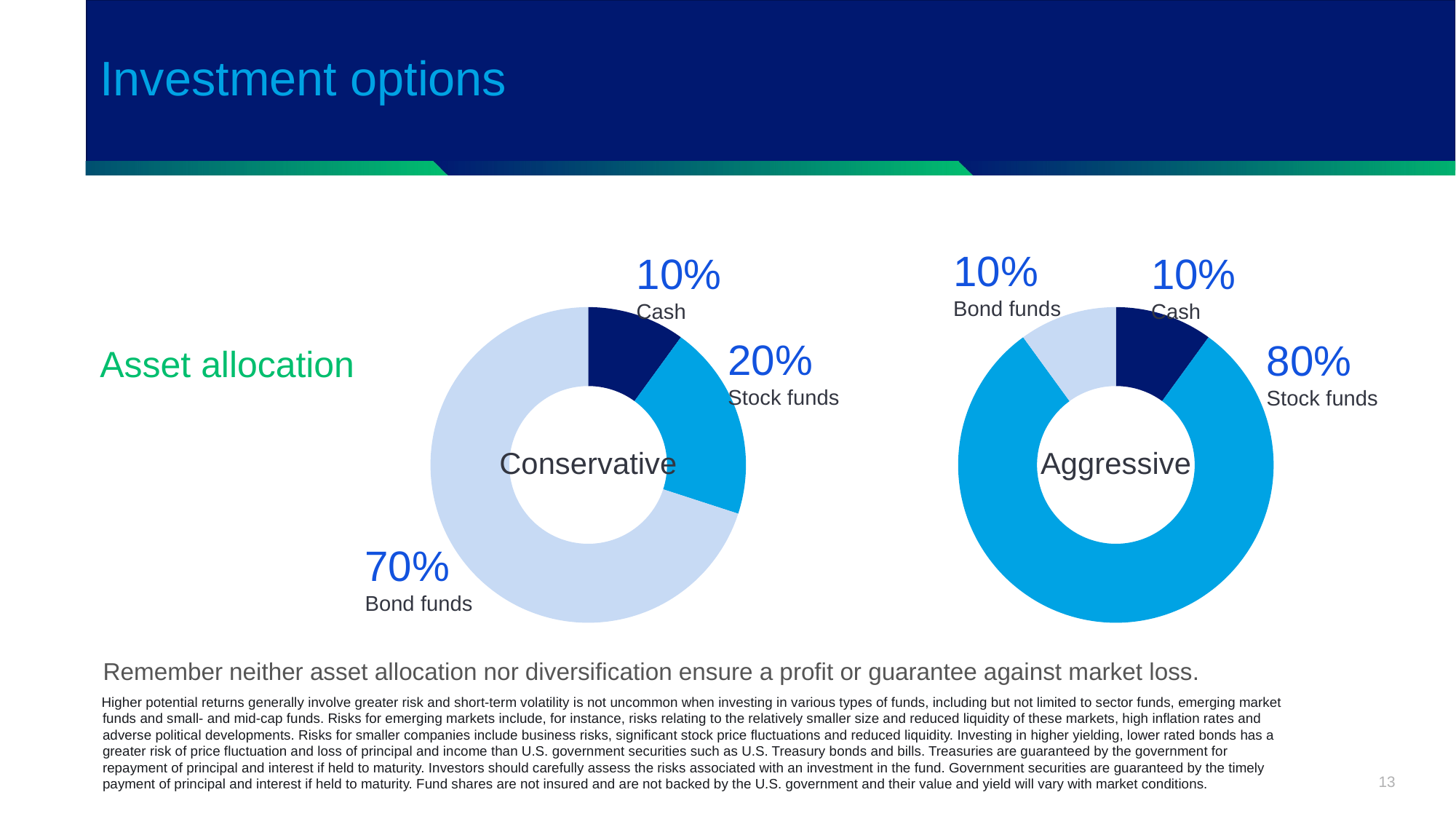
In the Conservative chart, what share is allocated to Bond funds? 70% In the Conservative chart, what share is allocated to Stock funds? 20% In the Aggressive chart, which category has the largest share? Stock funds In the Conservative chart, which category has the smallest share? Cash In the Conservative chart, what is the difference between the Bond funds share and the Stock funds share? 50 percentage points In the Aggressive chart, what share is allocated to Stock funds? 80% Which is larger: the Stock funds share in the Aggressive chart or the Bond funds share in the Conservative chart? Stock funds in the Aggressive chart What is the label in the centre of the right-hand chart? Aggressive How many categories does the Aggressive chart show? 3 In the Aggressive chart, what share is allocated to Bond funds? 10% What kind of chart is the Conservative chart? Doughnut (pie) chart In the Conservative chart, which category has the largest share? Bond funds